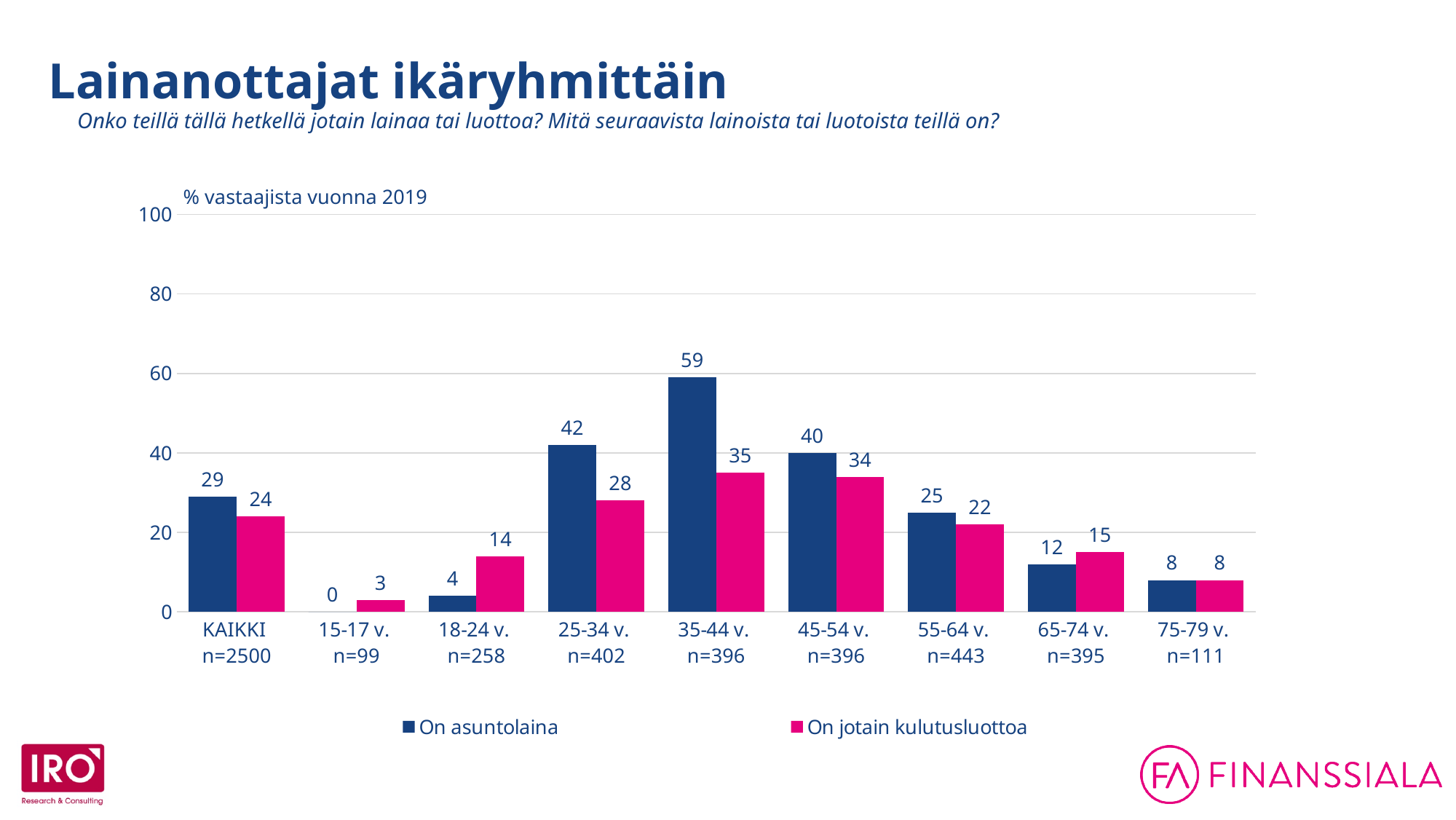
What is the value for 'On asuntolaina' in the 35-44 v. age group? 59 Which age group has the lowest value for 'On jotain kulutusluottoa'? 15-17 v. How many series does the legend list? 2 Is the value for 'On asuntolaina' in the 25-34 v. age group greater or less than 40? greater Which age group has the highest value for 'On asuntolaina'? 35-44 v. How many categories are shown on the x axis? 9 What is the value for 'On jotain kulutusluottoa' in the 18-24 v. age group? 14 What kind of chart is shown on the slide? Bar chart In the 65-74 v. age group, which is larger: 'On asuntolaina' or 'On jotain kulutusluottoa'? On jotain kulutusluottoa What is the sample size (n) shown for the 55-64 v. age group? n=443 What is the difference between 'On asuntolaina' and 'On jotain kulutusluottoa' in the 35-44 v. age group? 24 What is the value for 'On asuntolaina' for KAIKKI? 29